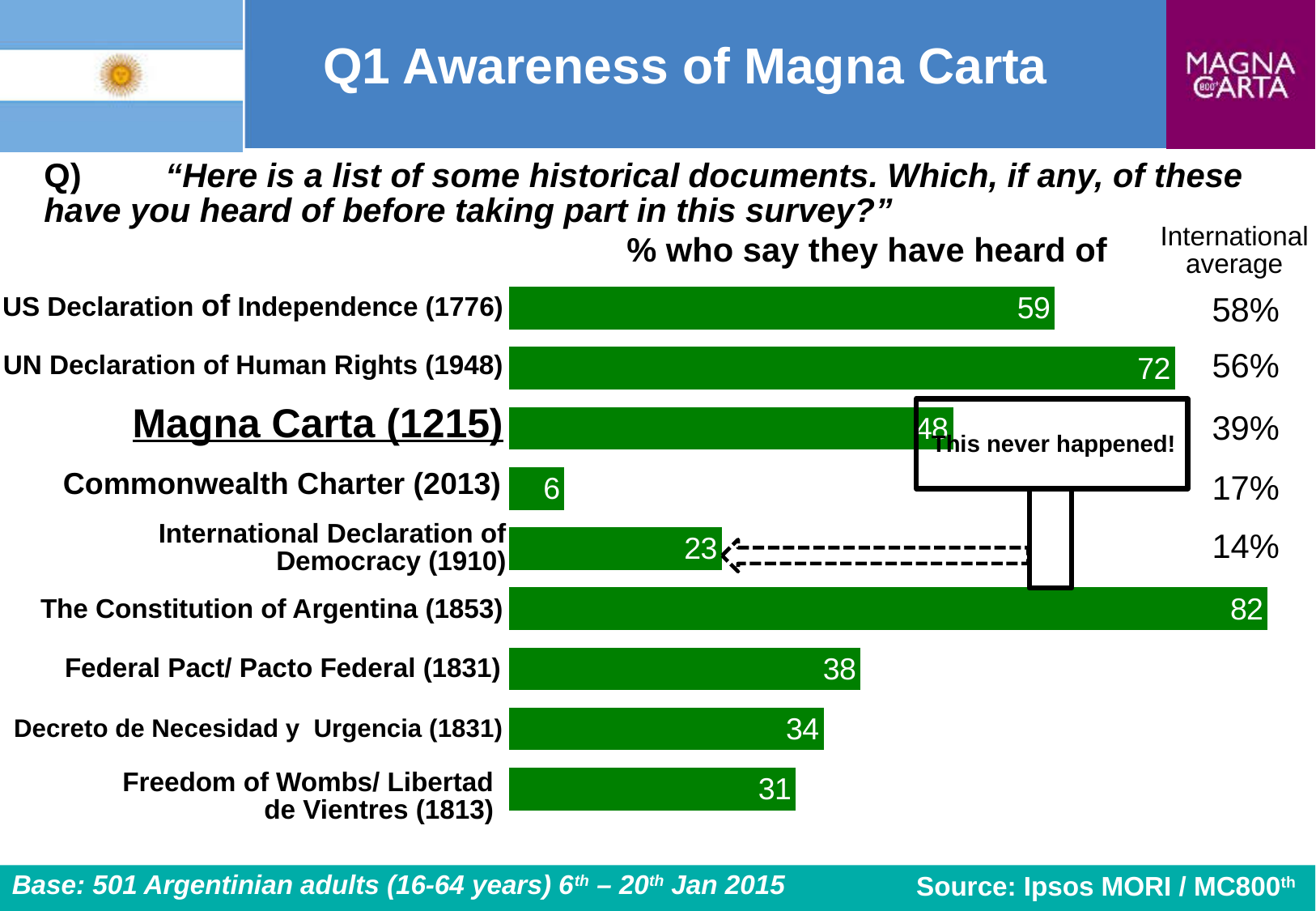
What is the difference between the values for the Constitution of Argentina (1853) and the Magna Carta (1215)? 34 How many documents are listed in the bar chart? 9 What is the value shown for Freedom of Wombs/ Libertad de Vientres (1813)? 31 What percentage of Argentinian adults say they have heard of the Magna Carta (1215)? 48 Which has a higher value: the US Declaration of Independence (1776) or the UN Declaration of Human Rights (1948)? UN Declaration of Human Rights (1948) What kind of chart is shown on the slide? Bar chart What is the value shown for the UN Declaration of Human Rights (1948)? 72 What is the value shown for the Commonwealth Charter (2013)? 6 What does the callout box on the chart say? This never happened! Which document has the lowest percentage of people who say they have heard of it? Commonwealth Charter (2013) What is the international average shown for the Magna Carta (1215)? 39% Which document has the highest percentage of people who say they have heard of it? The Constitution of Argentina (1853)